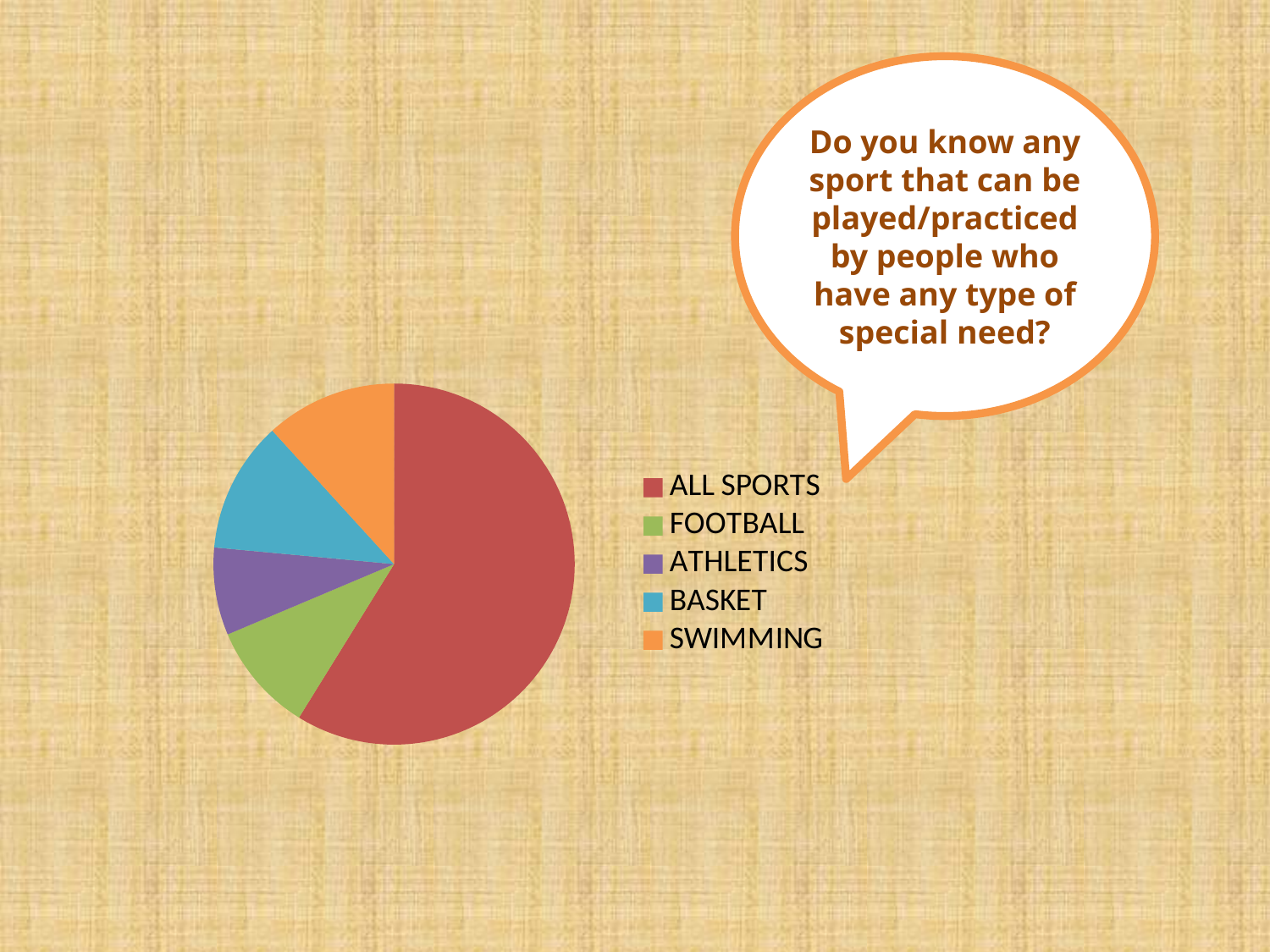
Which category has the largest slice of the pie chart? ALL SPORTS Which is larger in the pie chart, ALL SPORTS or BASKET? ALL SPORTS Which is larger in the pie chart, ALL SPORTS or SWIMMING? ALL SPORTS What kind of chart is shown on the slide? pie chart How many categories does the pie chart have? 5 Which colour represents SWIMMING in the pie chart? orange Does the FOOTBALL slice take up more or less than a quarter of the pie chart? less Which category is shown in red in the pie chart? ALL SPORTS Does the ALL SPORTS slice take up more or less than half of the pie chart? more